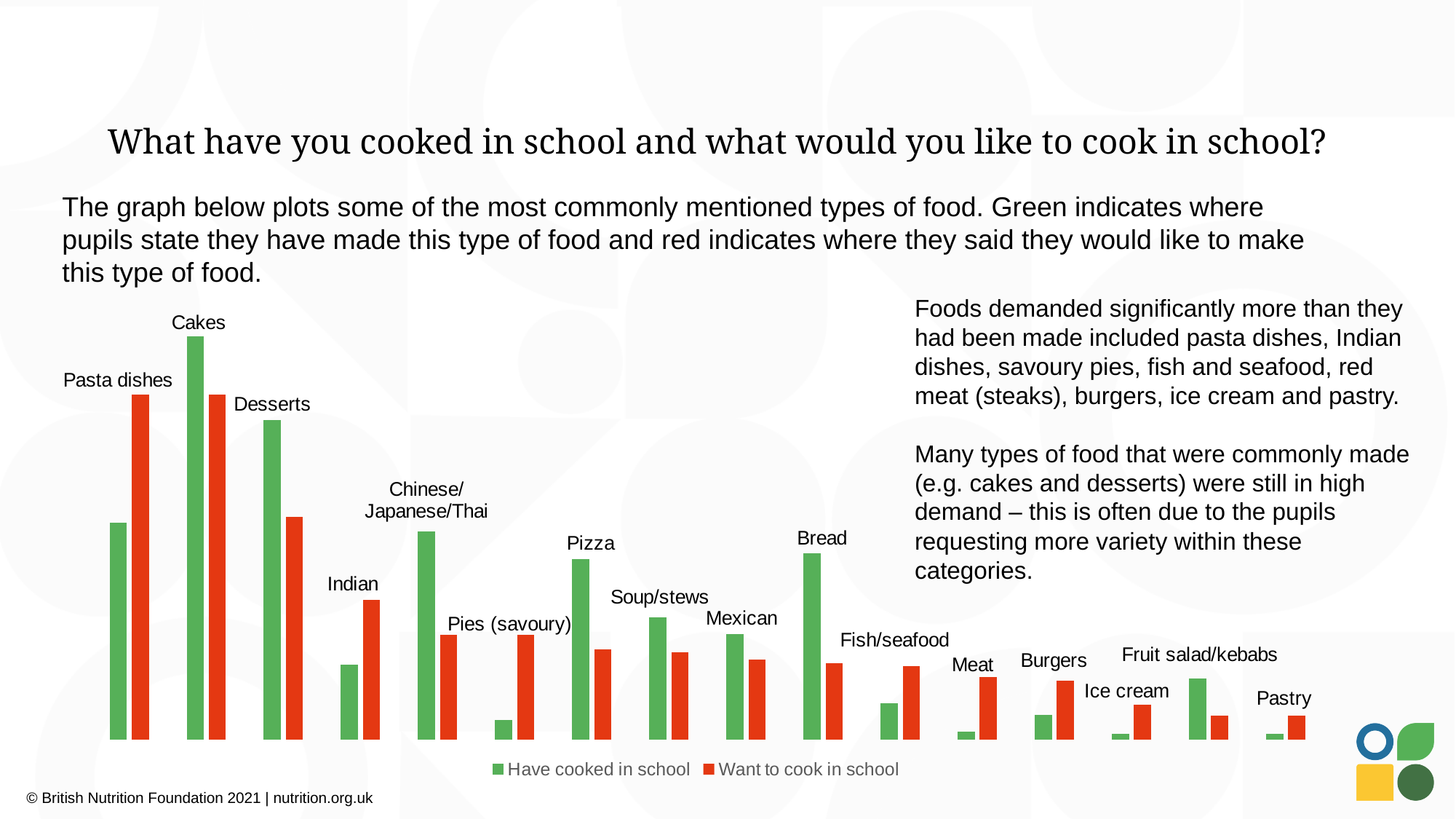
How many food categories are plotted in the chart? 16 For Pies (savoury), which is larger: 'Have cooked in school' or 'Want to cook in school'? Want to cook in school For Pasta dishes, which is larger: 'Have cooked in school' or 'Want to cook in school'? Want to cook in school Which has the higher 'Have cooked in school' bar: Cakes or Desserts? Cakes How many series does the legend list? 2 Which food category has the highest 'Have cooked in school' bar? Cakes What kind of chart is shown on the slide? bar chart What is the first legend entry of the chart? Have cooked in school Which colour represents 'Want to cook in school' in the chart? red